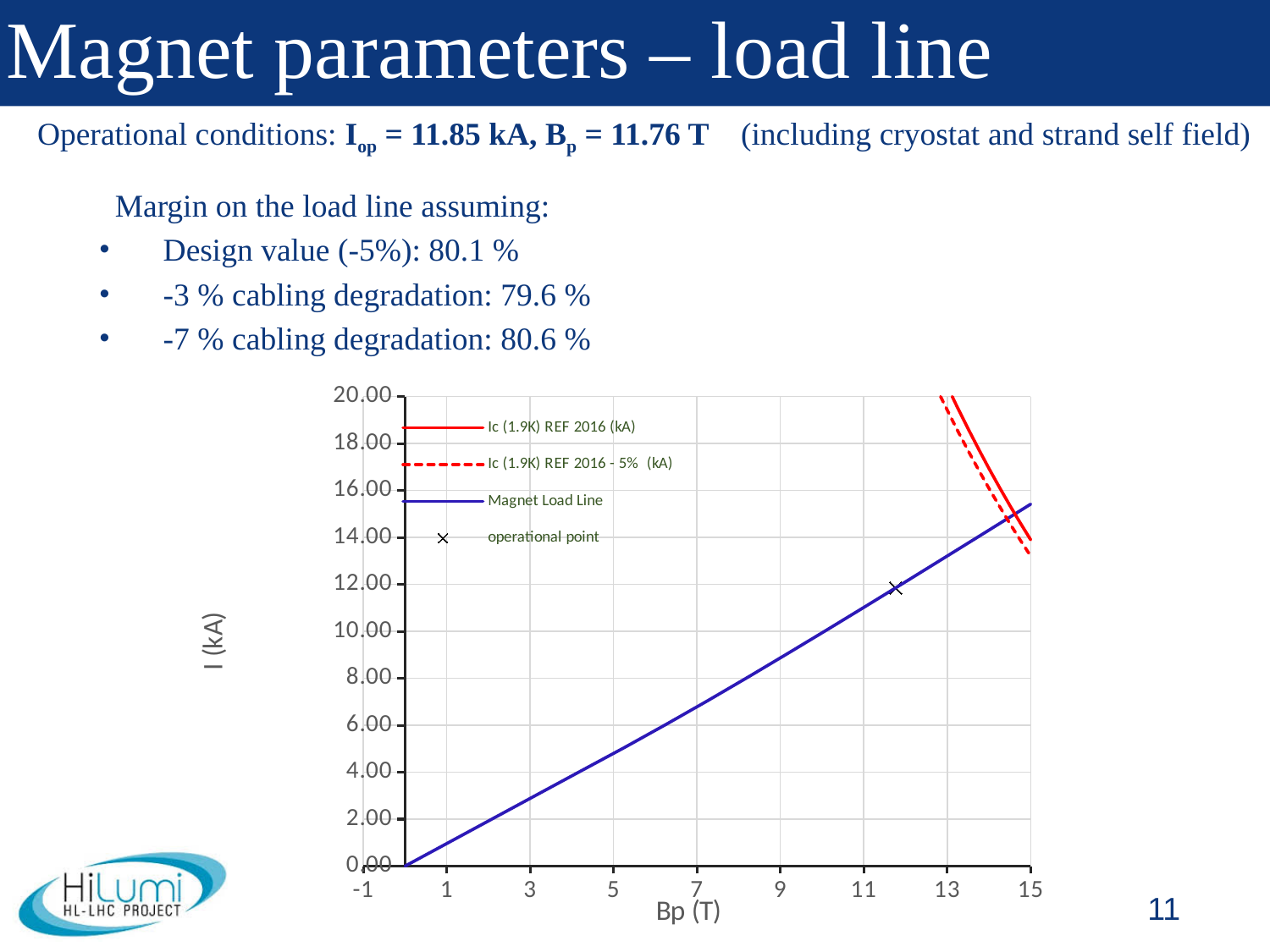
Is the current at the operational point greater or less than 10 kA? greater What is the operational current I_op stated on the slide for the operational point? 11.85 kA Is the value of the Magnet Load Line at Bp = 7 T greater or less than 8 kA? less At Bp = 14 T, which is larger: the Ic (1.9K) REF 2016 (kA) curve or the Magnet Load Line? Ic (1.9K) REF 2016 (kA) Is the value of the Magnet Load Line at Bp = 15 T greater or less than 14 kA? greater How many series does the chart legend list? 4 Does the Magnet Load Line rise or fall as Bp increases? rise What kind of chart is shown on the slide? line chart Does the Ic (1.9K) REF 2016 (kA) curve rise or fall as Bp increases? fall What is the title of the x axis of the chart? Bp (T) What is the title of the y axis of the chart? I (kA)